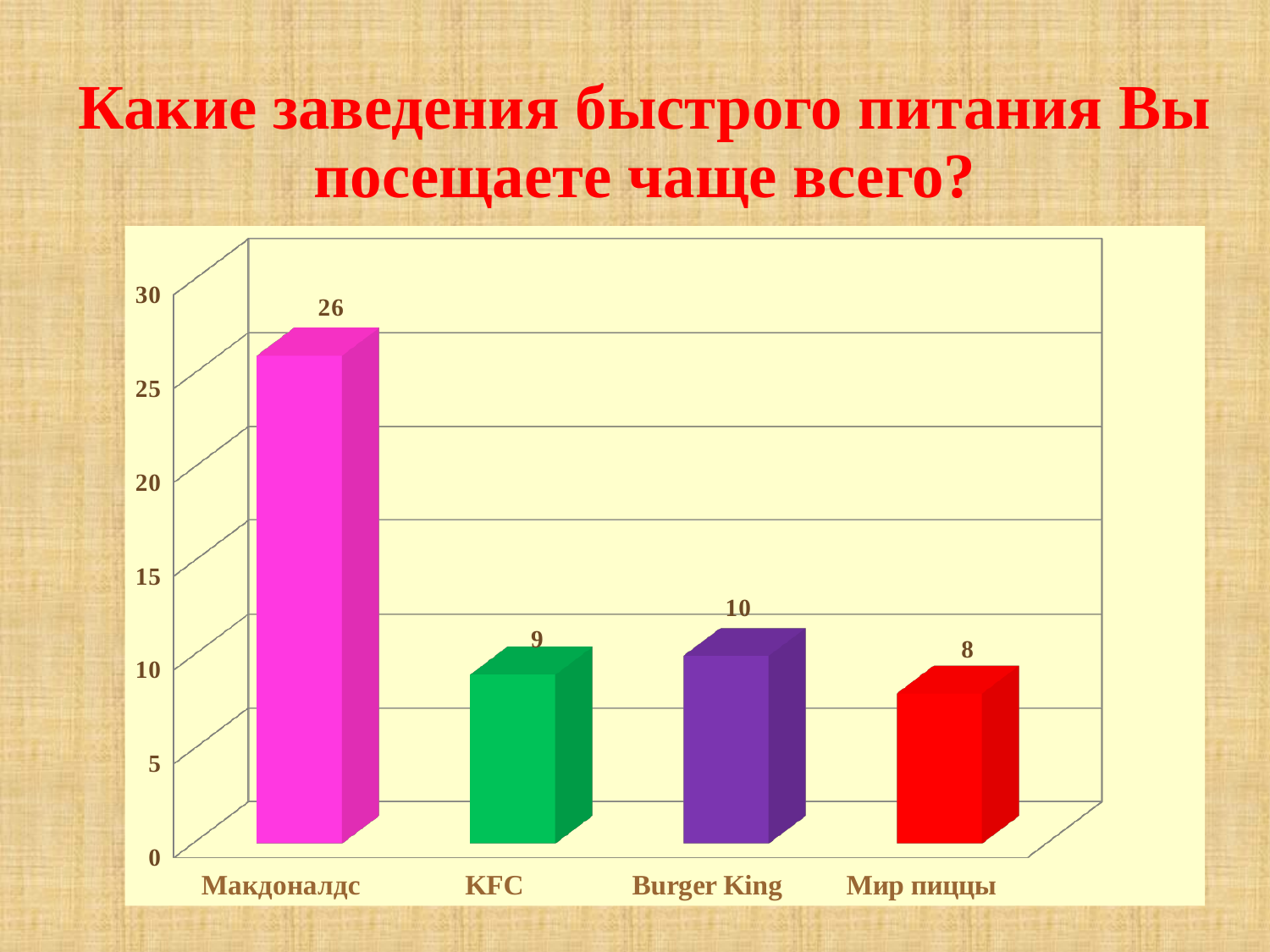
What is the value for Макдоналдс? 26 Which is larger, the value for Макдоналдс or the value for KFC? Макдоналдс Which category has the highest value? Макдоналдс What is the difference between the values for KFC and Мир пиццы? 1 What is the value for KFC? 9 What is the value for Burger King? 10 Which category has the lowest value? Мир пиццы What kind of chart is shown on the slide? bar chart How many categories are shown on the chart? 4 What is the difference between the values for Макдоналдс and Burger King? 16 Is the value for Макдоналдс greater or less than 20? greater What is the value for Мир пиццы? 8